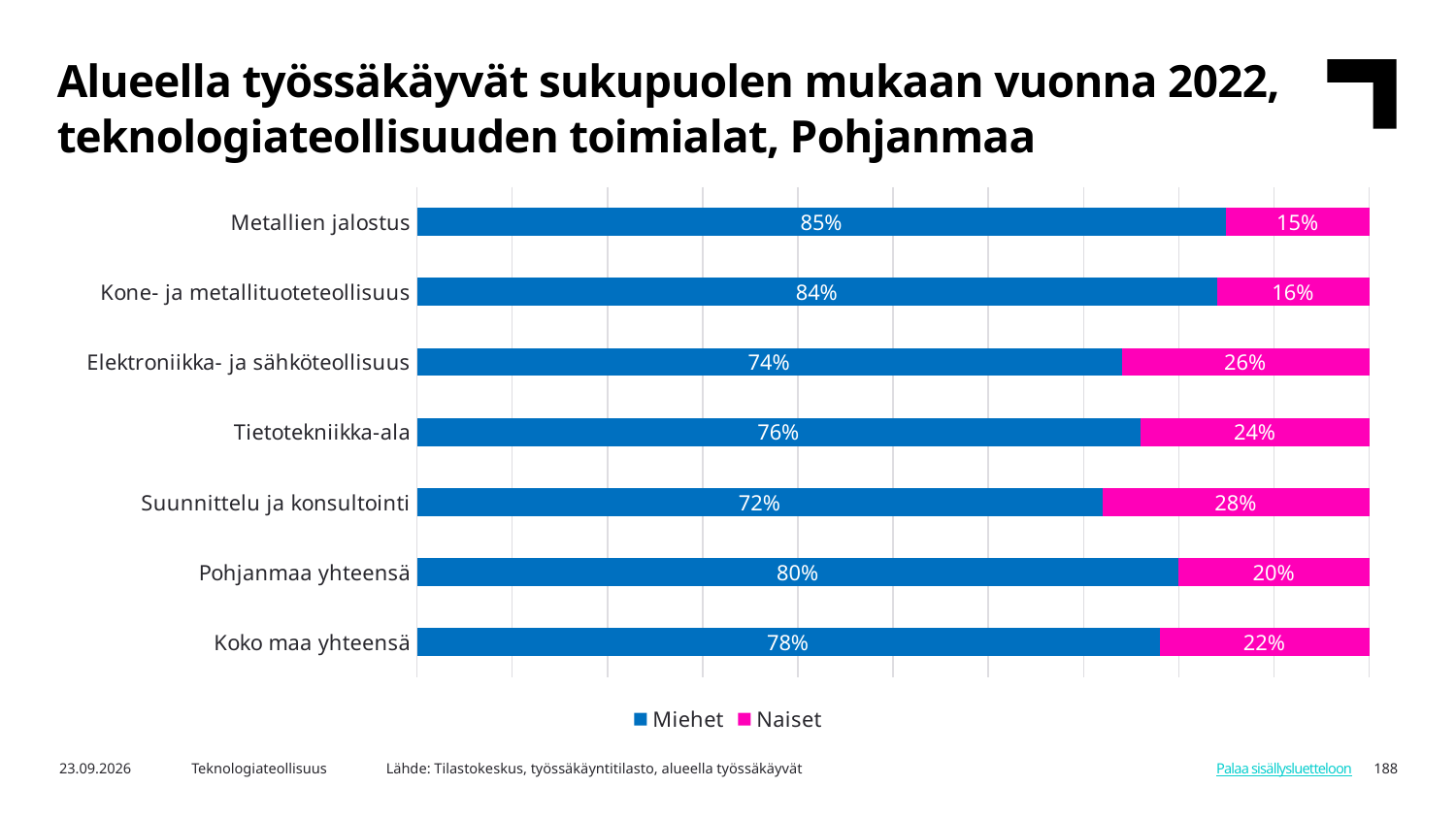
Which has a larger Naiset share, Tietotekniikka-ala or Elektroniikka- ja sähköteollisuus? Elektroniikka- ja sähköteollisuus What is the difference between the Miehet share for Metallien jalostus and for Suunnittelu ja konsultointi? 13 percentage points What is the Naiset share for Pohjanmaa yhteensä? 20% What kind of chart is shown on the slide? Stacked bar chart What is the total of the stacked bar for Kone- ja metallituoteteollisuus? 100% What is the Miehet share for Metallien jalostus? 85% What is the Naiset share for Suunnittelu ja konsultointi? 28% What is the Miehet share for Koko maa yhteensä? 78% How many series does the legend list? 2 Which category has the lowest Naiset share? Metallien jalostus Which category has the highest Naiset share? Suunnittelu ja konsultointi How many categories are shown on the chart? 7